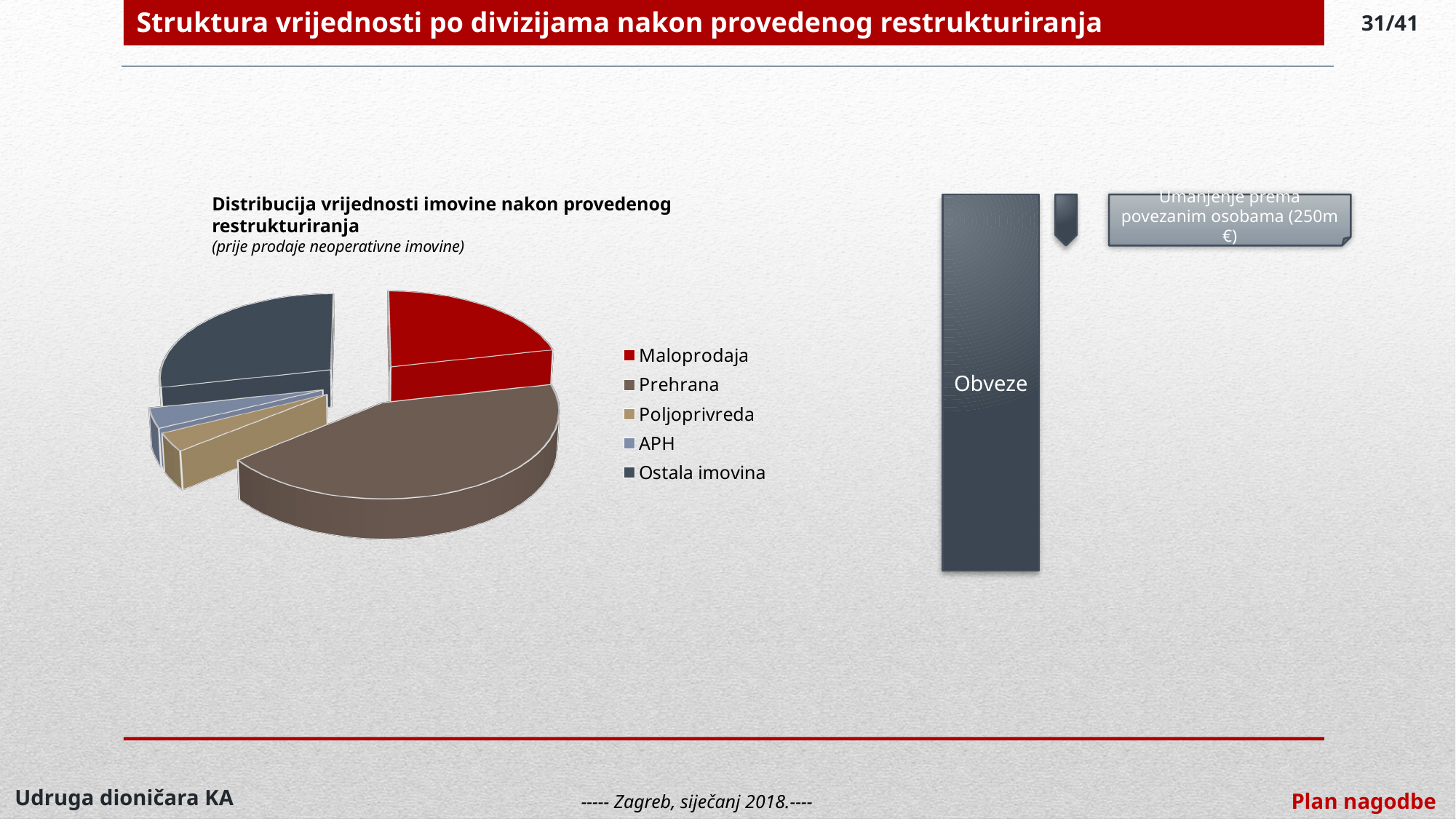
Which slice is larger, Poljoprivreda or APH? APH Which slice is larger, Prehrana or Maloprodaja? Prehrana What kind of chart is shown on the slide? Pie chart Which slice is larger, Ostala imovina or Poljoprivreda? Ostala imovina Which category has the smallest slice in the pie chart? Poljoprivreda Which category has the largest slice in the pie chart? Prehrana What is the title of the pie chart? Distribucija vrijednosti imovine nakon provedenog restrukturiranja How many categories does the pie chart show? 5 Which category is shown in red in the pie chart? Maloprodaja